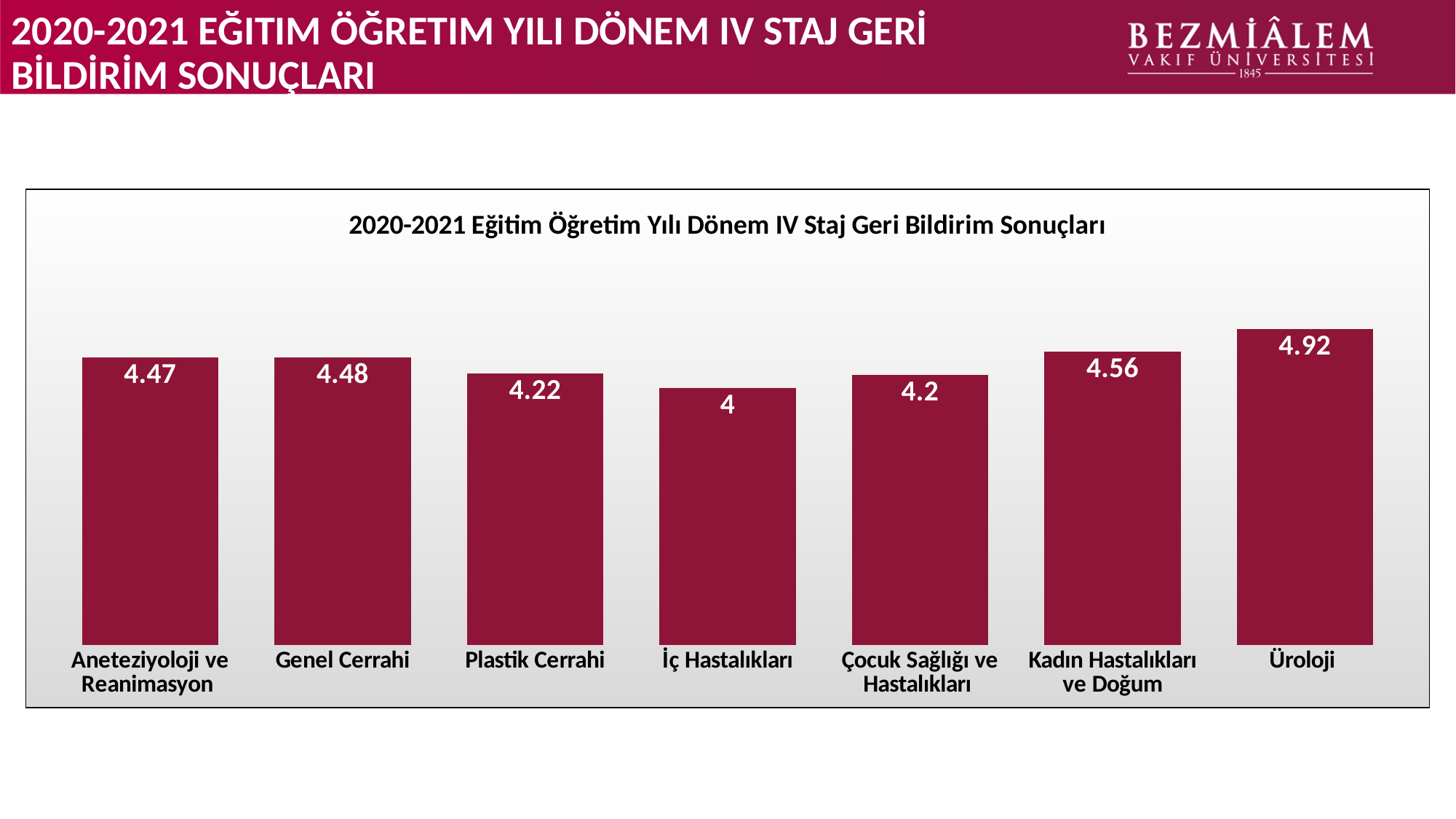
What is the value for Plastik Cerrahi? 4.22 Which category has the lowest value? İç Hastalıkları What is the value for Kadın Hastalıkları ve Doğum? 4.56 What is the difference between the values for Kadın Hastalıkları ve Doğum and Çocuk Sağlığı ve Hastalıkları? 0.36 How many categories are shown in the chart? 7 Which category has the highest value? Üroloji What is the value for İç Hastalıkları? 4 What is the value for Üroloji? 4.92 What is the difference between the values for Üroloji and İç Hastalıkları? 0.92 Which is larger, the value for Genel Cerrahi or the value for Plastik Cerrahi? Genel Cerrahi What is the title of the chart? 2020-2021 Eğitim Öğretim Yılı Dönem IV Staj Geri Bildirim Sonuçları What kind of chart is shown on the slide? Bar chart